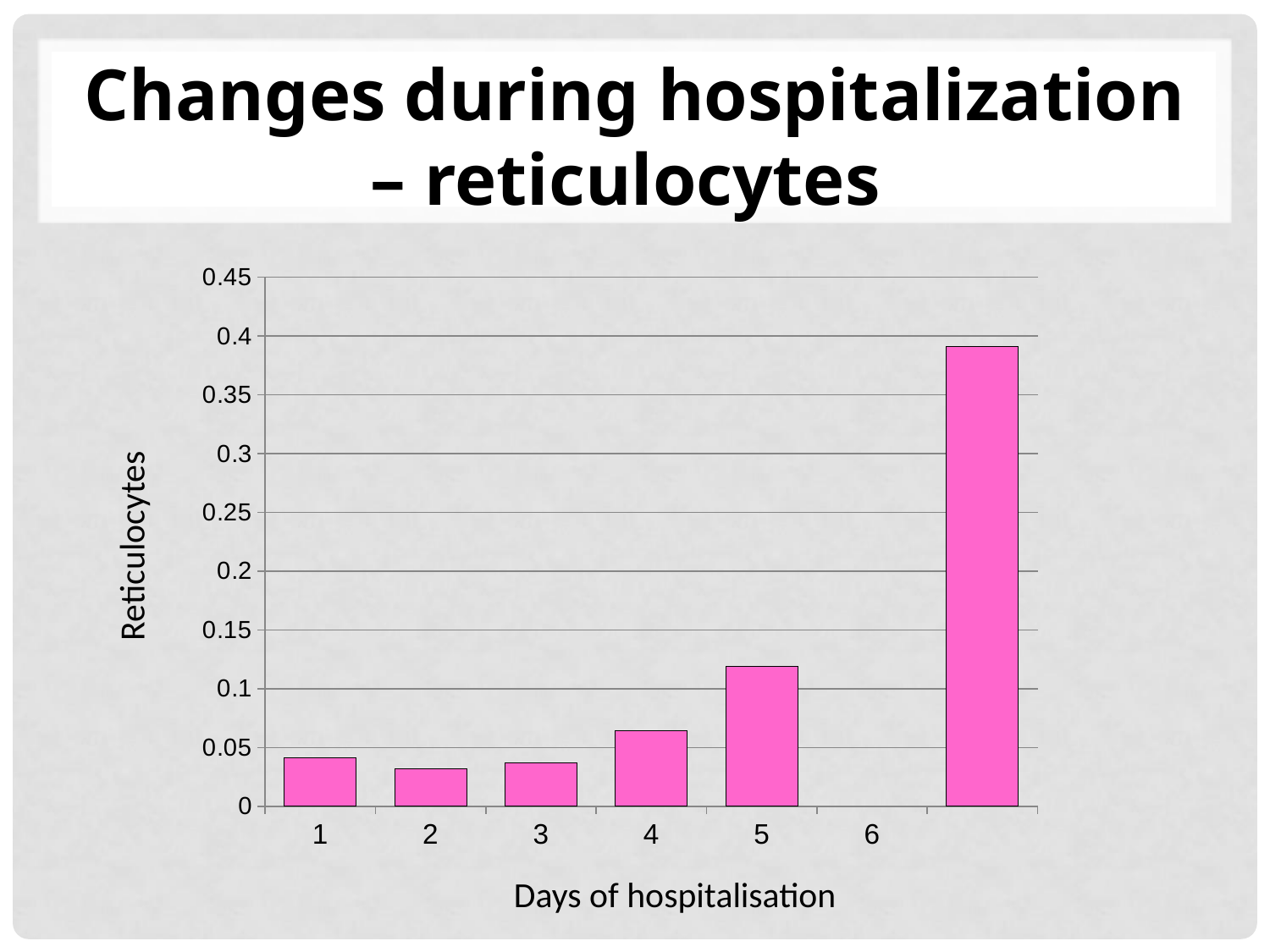
How many day labels are shown on the x axis? 6 Which is larger, the value for day 4 or the value for day 5? day 5 What is the title of the x axis? Days of hospitalisation Is the value for day 2 greater or less than 0.05? less Is the value for day 5 greater or less than 0.1? greater From day 3 to day 5, do the reticulocyte values rise or fall? rise Among days 1 to 5, which day has the highest reticulocyte value? 5 Is the tallest bar on the chart greater or less than 0.35? greater What is the title of the y axis? Reticulocytes What kind of chart is shown on the slide? bar chart